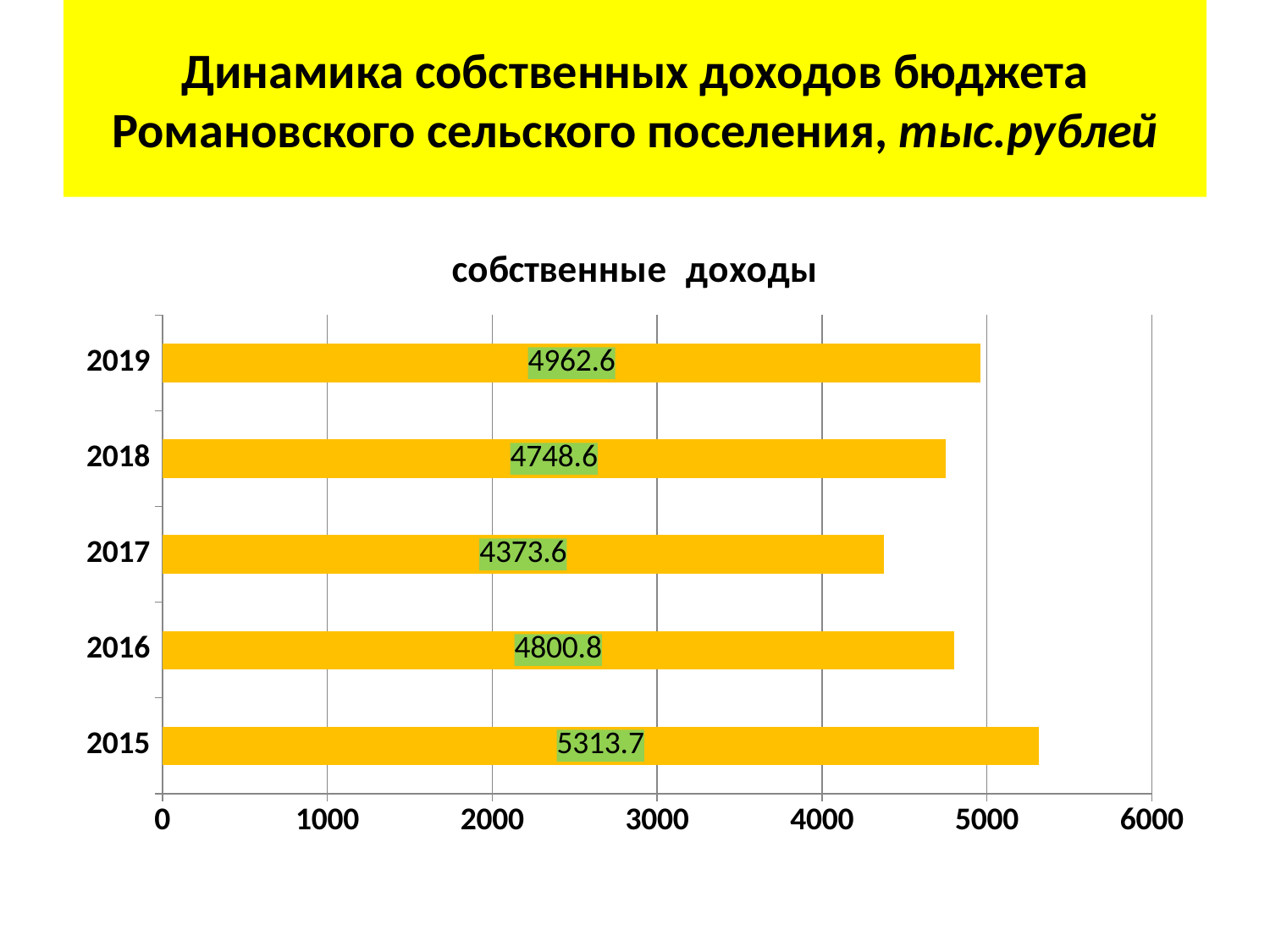
What is the difference between the values for 2015 and 2017? 940.1 Which year has the highest value? 2015 What is the value for 2015? 5313.7 Which is larger, the value for 2016 or the value for 2018? 2016 What is the difference between the values for 2019 and 2018? 214.0 Which year has the lowest value? 2017 What is the value for 2019? 4962.6 Is the value for 2017 greater or less than 5000? less What is the title of the chart? собственные доходы How many years are shown on the chart? 5 What kind of chart is shown on the slide? bar chart What is the value for 2017? 4373.6